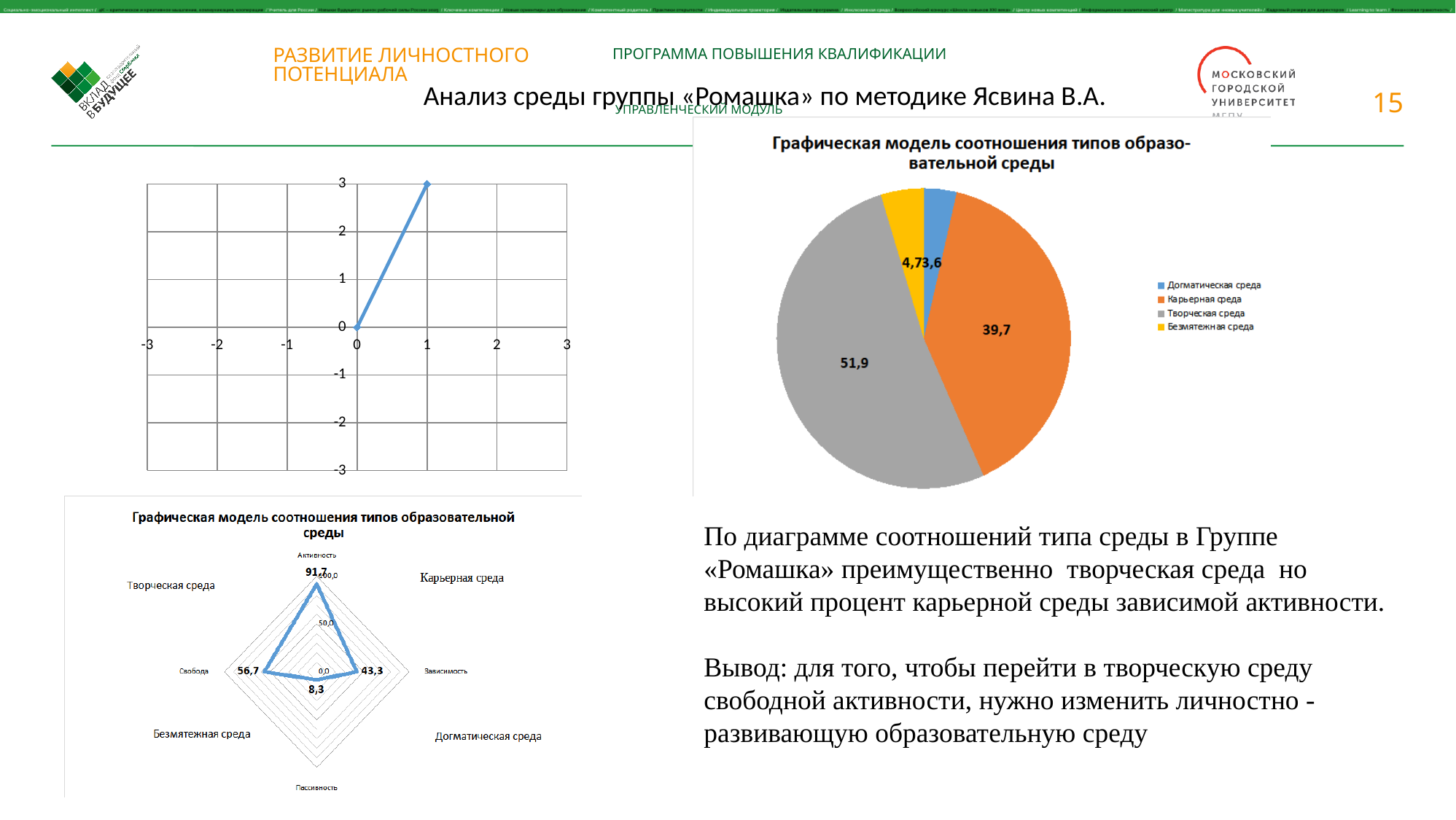
In the radar chart at the bottom left, which axis has the lowest value? Пассивность In the radar chart at the bottom left, what is the value for Активность? 91,7 How many entries does the legend of the pie chart on the right list? 4 In the radar chart at the bottom left, what is the difference between the values for Свобода and Зависимость? 13,4 In the pie chart on the right, which is larger: Карьерная среда or Творческая среда? Творческая среда In the pie chart on the right, what is the value shown for Карьерная среда? 39,7 In the radar chart at the bottom left, what is the value for Свобода? 56,7 In the line chart at the top left, what is the y value of the point at x = 1? 3 In the pie chart on the right, what is the value shown for Творческая среда? 51,9 In the pie chart on the right, what is the difference between the values for Творческая среда and Карьерная среда? 12,2 What kind of chart is the chart in the top right of the slide? Pie chart In the pie chart on the right, which category has the largest slice? Творческая среда